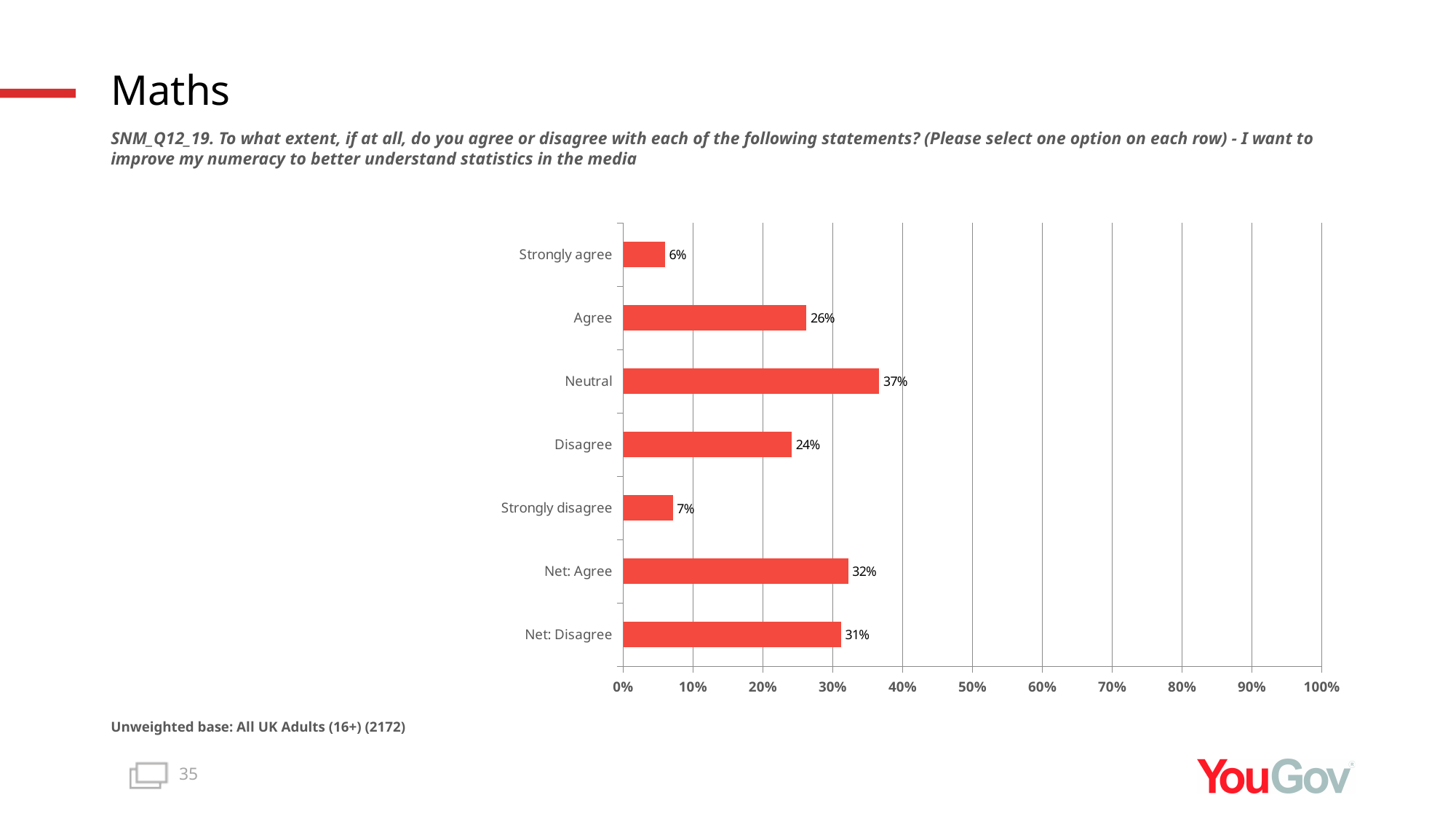
What kind of chart is shown on the slide? Bar chart What is the difference between the 'Agree' and 'Disagree' values? 2% Is the value for 'Net: Agree' greater or less than 30%? greater What is the value shown for 'Strongly agree'? 6% What is the value shown for 'Net: Disagree'? 31% Which category has the highest value? Neutral Which category has the lowest value? Strongly agree What is the unweighted base stated below the chart? All UK Adults (16+) (2172) Which is larger, 'Strongly agree' or 'Strongly disagree'? Strongly disagree How many categories are shown on the chart? 7 What is the difference between 'Neutral' and 'Net: Agree'? 5% What percentage of respondents selected 'Neutral'? 37%